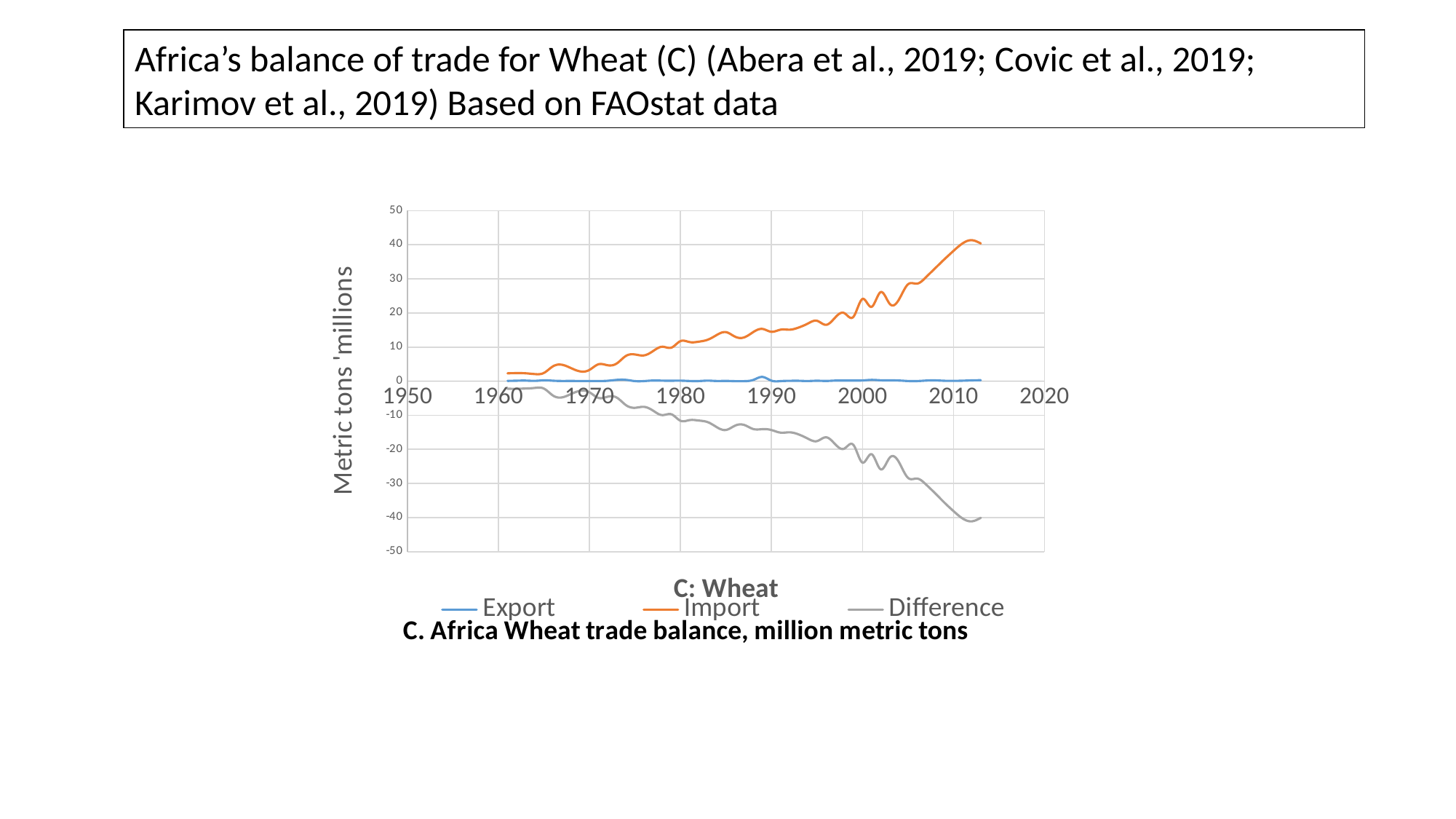
Is the value for Difference in 2010 greater or less than -30? less Which series reaches the lowest value on the chart? Difference Is the value for Export in 2000 greater or less than 10? less Is the value for Import in 2010 greater or less than 30? greater Which series are listed in the legend? Export, Import, Difference What kind of chart is shown on the slide? line chart Which series reaches the highest value on the chart? Import Does the Difference series rise or fall over time from 1960 to 2010? fall What is the label on the vertical axis? Metric tons 'millions Does the Import series rise or fall over time from 1960 to 2010? rise In 2000, which is larger, Import or Export? Import How many series does the legend list? 3